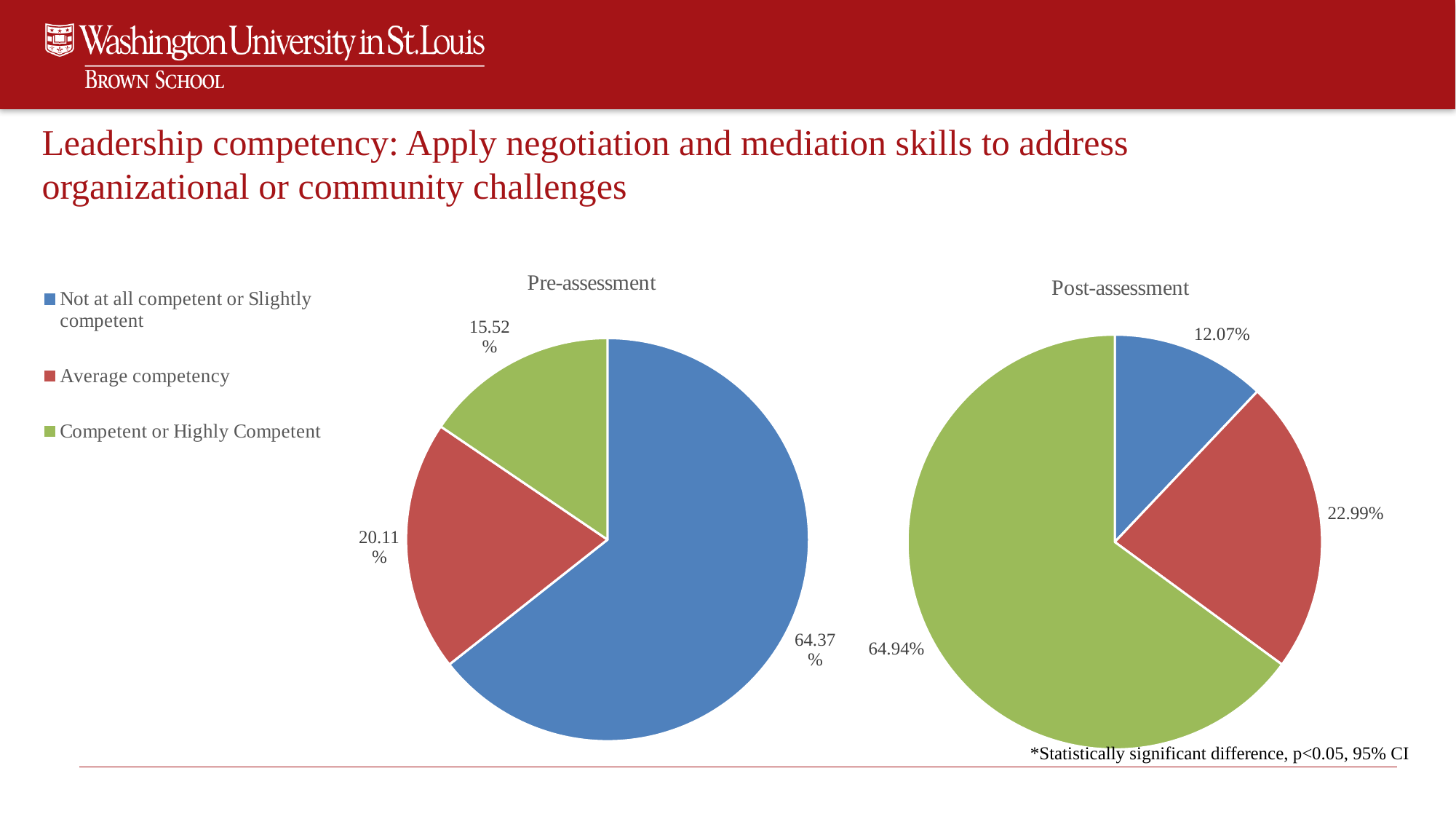
In the Post-assessment chart, which is larger: the 'Average competency' slice or the 'Not at all competent or Slightly competent' slice? Average competency In the Pre-assessment chart, what share is labelled for the 'Not at all competent or Slightly competent' slice? 64.37% In the Pre-assessment chart, which category has the largest slice? Not at all competent or Slightly competent In the Pre-assessment chart, what share is labelled for the 'Average competency' slice? 20.11% What type of chart is the Pre-assessment chart? Pie chart In the Post-assessment chart, what share is labelled for the 'Average competency' slice? 22.99% How many categories does the legend list? 3 In the Post-assessment chart, what share is labelled for the 'Not at all competent or Slightly competent' slice? 12.07% What is the difference in percentage points between the 'Competent or Highly Competent' share in the Post-assessment chart and in the Pre-assessment chart? 49.42 In the Post-assessment chart, which category has the smallest slice? Not at all competent or Slightly competent In the Pre-assessment chart, what share is labelled for the 'Competent or Highly Competent' slice? 15.52% In the Post-assessment chart, what share is labelled for the 'Competent or Highly Competent' slice? 64.94%